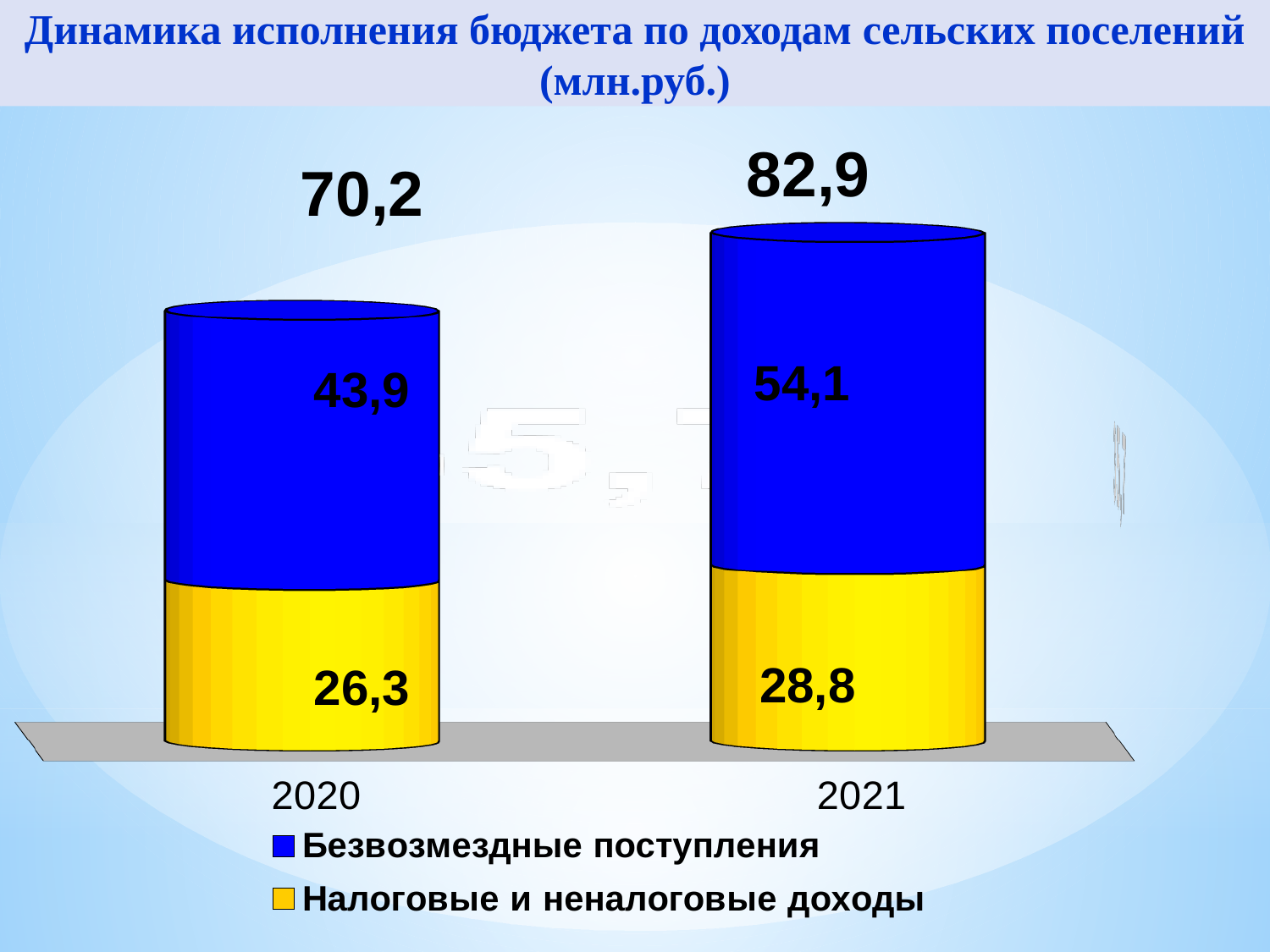
What is the value of Налоговые и неналоговые доходы for 2020? 26,3 What is the value of Безвозмездные поступления for 2021? 54,1 What is the total of the stacked bar for 2020? 70,2 Which year has the higher total revenue? 2021 How many series does the legend list? 2 What kind of chart is shown on the slide? Stacked bar chart How many categories (years) are shown on the x axis? 2 What is the difference between the Безвозмездные поступления values for 2021 and 2020? 10,2 Which is larger: Налоговые и неналоговые доходы in 2020 or in 2021? 2021 What is the total of the stacked bar for 2021? 82,9 What is the value of Безвозмездные поступления for 2020? 43,9 What is the value of Налоговые и неналоговые доходы for 2021? 28,8